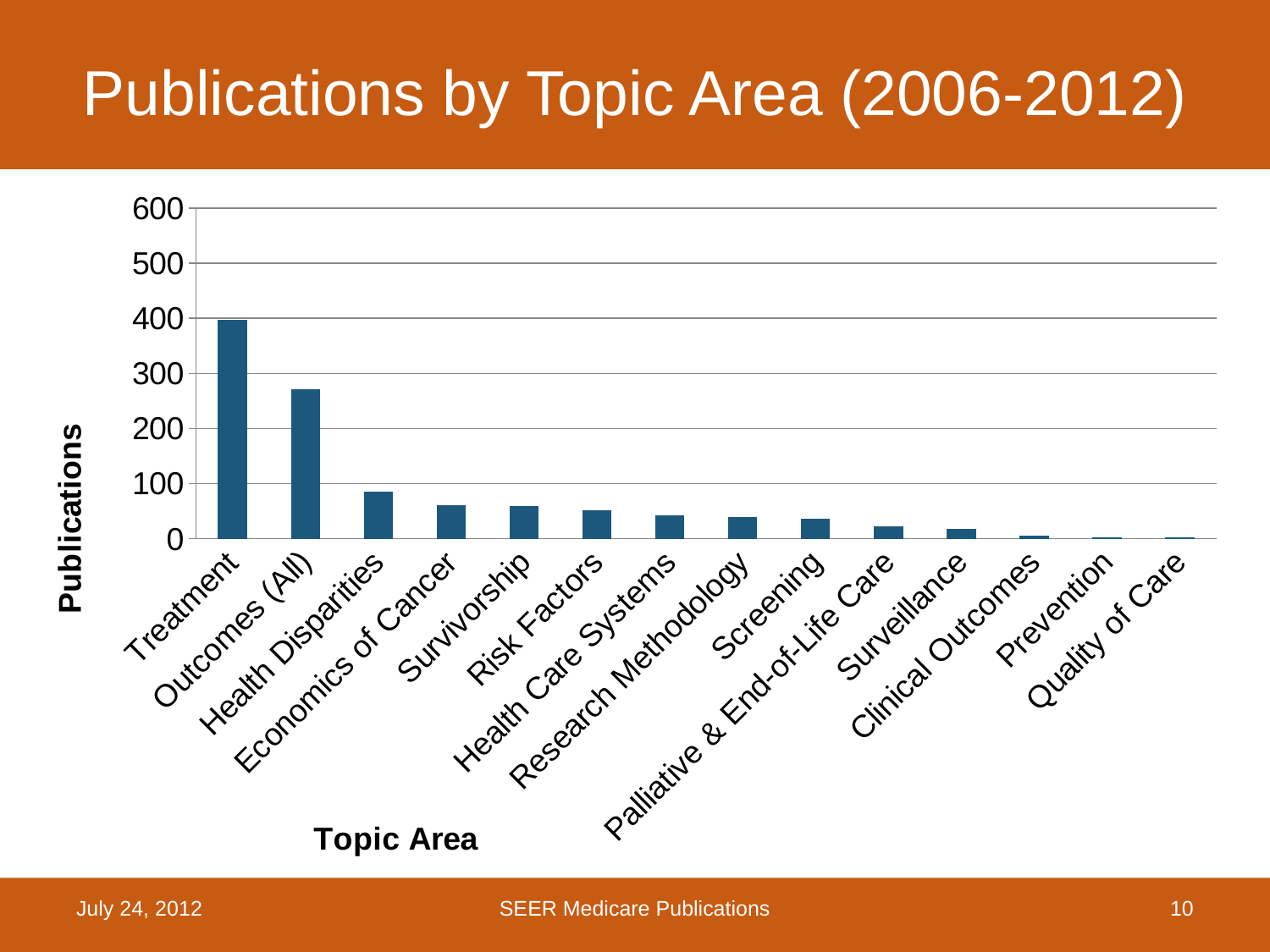
What is the label of the y axis? Publications Which has more publications, Treatment or Outcomes (All)? Treatment Is the value for Screening greater or less than 100? less Is the value for Outcomes (All) greater or less than 200? greater Is the value for Treatment greater or less than 300? greater What kind of chart is shown on the slide? bar chart Which topic area has the highest number of publications? Treatment Which has more publications, Health Disparities or Surveillance? Health Disparities How many topic areas are shown on the x axis? 14 Do the bar values rise or fall moving from left to right along the x axis? fall